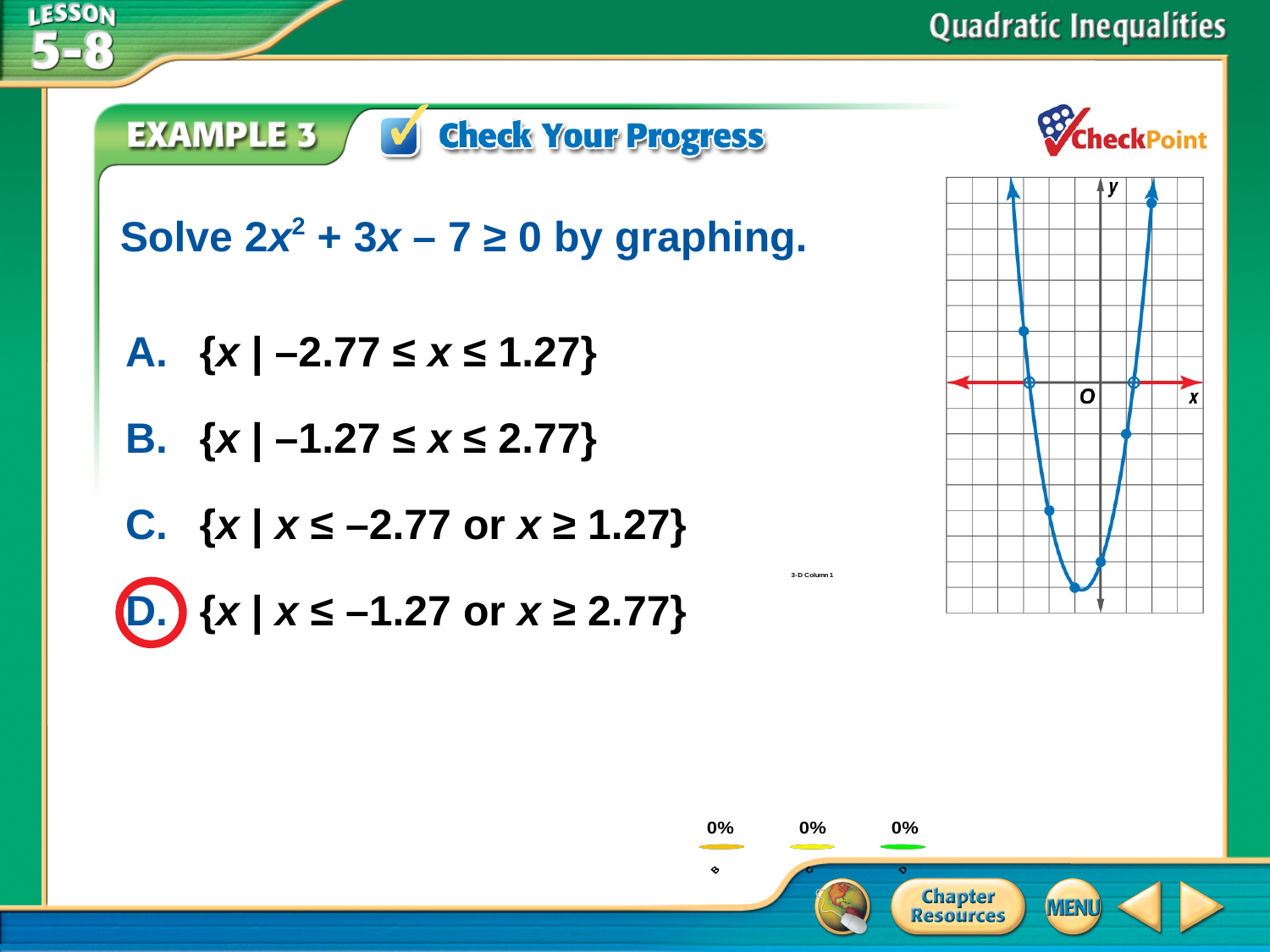
What value is printed above the first bar of the small bar chart? 0% Do the values in the small bar chart rise, fall, or stay the same from left to right? stay the same What value is printed above the middle bar of the small bar chart? 0% How many data labels are printed on the small bar chart? 3 What value is printed above the last bar of the small bar chart? 0% What is the difference between the first and last bar values in the small bar chart? 0% What kind of chart is the small chart near the bottom of the slide? bar chart